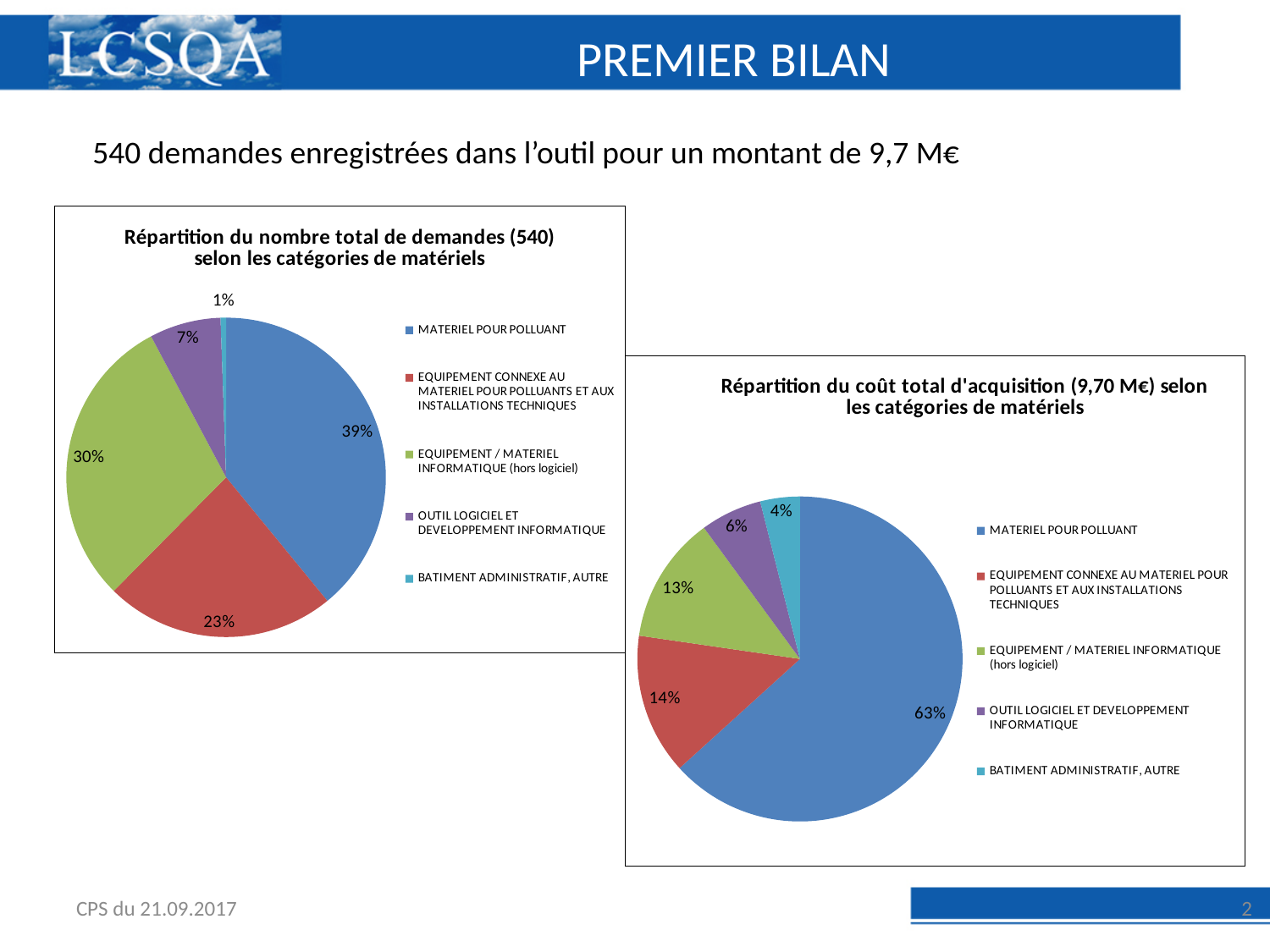
In the left chart (Répartition du nombre total de demandes), what share is EQUIPEMENT / MATERIEL INFORMATIQUE (hors logiciel)? 30% In the right chart (Répartition du coût total d'acquisition), what is the difference between the MATERIEL POUR POLLUANT share and the EQUIPEMENT CONNEXE share? 49% In the right chart (Répartition du coût total d'acquisition), which is larger: the share for EQUIPEMENT CONNEXE or the share for EQUIPEMENT / MATERIEL INFORMATIQUE? EQUIPEMENT CONNEXE In the left chart (Répartition du nombre total de demandes), how many categories does the legend list? 5 In the right chart (Répartition du coût total d'acquisition), what share is OUTIL LOGICIEL ET DEVELOPPEMENT INFORMATIQUE? 6% What total amount is stated in the title of the right chart? 9,70 M€ In the left chart (Répartition du nombre total de demandes), which category has the smallest share? BATIMENT ADMINISTRATIF, AUTRE In the right chart (Répartition du coût total d'acquisition), what share of cost is MATERIEL POUR POLLUANT? 63% In the right chart (Répartition du coût total d'acquisition), which category has the largest share? MATERIEL POUR POLLUANT In the left chart (Répartition du nombre total de demandes), what is the difference between the MATERIEL POUR POLLUANT share and the EQUIPEMENT CONNEXE share? 16% In the left chart (Répartition du nombre total de demandes), what share of requests is for MATERIEL POUR POLLUANT? 39% What type of chart is the left chart (Répartition du nombre total de demandes)? Pie chart